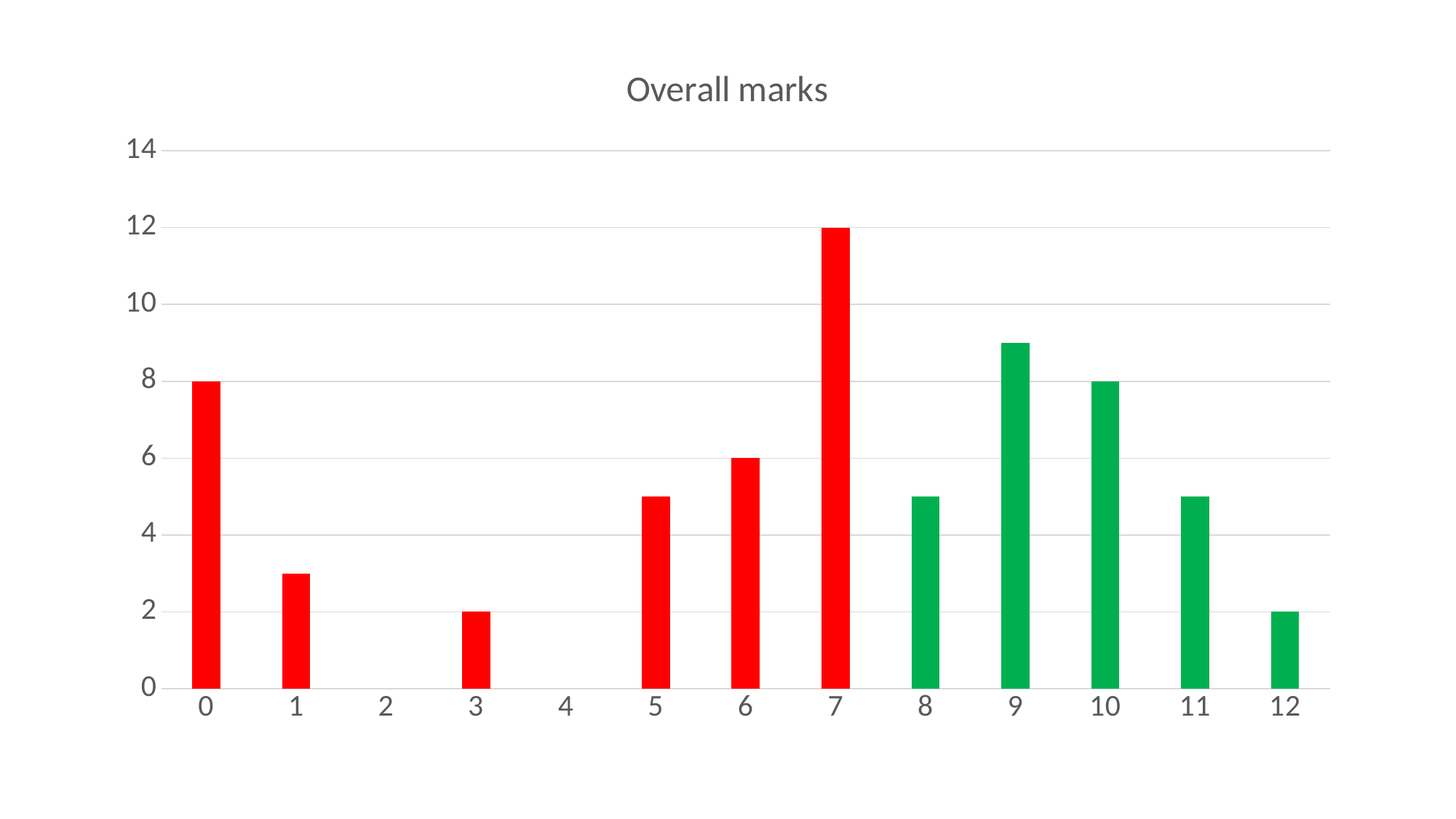
Is the value for category 1 greater or less than 4? less What kind of chart is shown on the slide? bar chart What is the value for category 12? 2 What is the value for category 6? 6 Which has the larger value, category 7 or category 9? 7 How many categories are shown on the x axis? 13 What is the value for category 7? 12 What is the difference between the values for category 7 and category 0? 4 What is the title of the chart? Overall marks What is the value for category 0? 8 Is the value for category 9 greater or less than 8? greater Which category has the highest value? 7